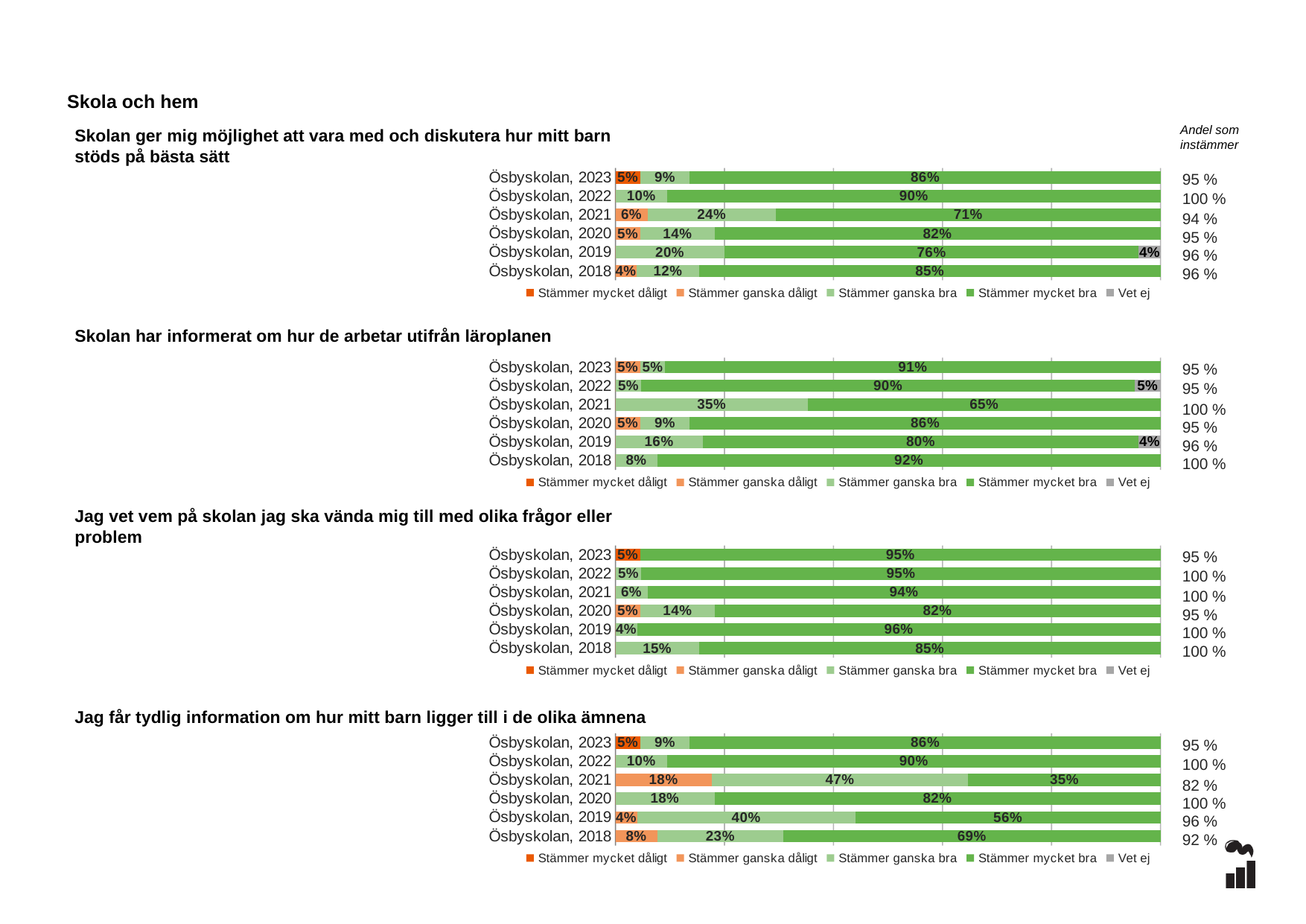
In the chart 'Skolan ger mig möjlighet att vara med och diskutera hur mitt barn stöds på bästa sätt', what is the 'Vet ej' value for Ösbyskolan, 2019? 4% In the chart 'Skolan ger mig möjlighet att vara med och diskutera hur mitt barn stöds på bästa sätt', which year has the highest 'Stämmer mycket bra' value? Ösbyskolan, 2022 In the chart 'Skolan har informerat om hur de arbetar utifrån läroplanen', what is the difference between the 'Stämmer mycket bra' values for Ösbyskolan, 2018 and Ösbyskolan, 2021? 27% In the chart 'Jag får tydlig information om hur mitt barn ligger till i de olika ämnena', which is larger: the 'Stämmer mycket bra' value for Ösbyskolan, 2019 or for Ösbyskolan, 2018? Ösbyskolan, 2018 What type of chart is used for 'Jag får tydlig information om hur mitt barn ligger till i de olika ämnena'? Stacked bar chart In the chart 'Skolan har informerat om hur de arbetar utifrån läroplanen', what is the 'Stämmer ganska bra' value for Ösbyskolan, 2021? 35% In the chart 'Jag vet vem på skolan jag ska vända mig till med olika frågor eller problem', what is the 'Stämmer mycket bra' value for Ösbyskolan, 2019? 96% In the chart 'Skolan har informerat om hur de arbetar utifrån läroplanen', how many series does the legend list? 5 In the chart 'Skolan ger mig möjlighet att vara med och diskutera hur mitt barn stöds på bästa sätt', what is the 'Stämmer mycket bra' value for Ösbyskolan, 2021? 71% In the chart 'Jag vet vem på skolan jag ska vända mig till med olika frågor eller problem', which year has the lowest 'Stämmer mycket bra' value? Ösbyskolan, 2020 In the chart 'Jag vet vem på skolan jag ska vända mig till med olika frågor eller problem', how many years (bars) are shown? 6 In the chart 'Jag får tydlig information om hur mitt barn ligger till i de olika ämnena', what is the 'Stämmer ganska dåligt' value for Ösbyskolan, 2021? 18%